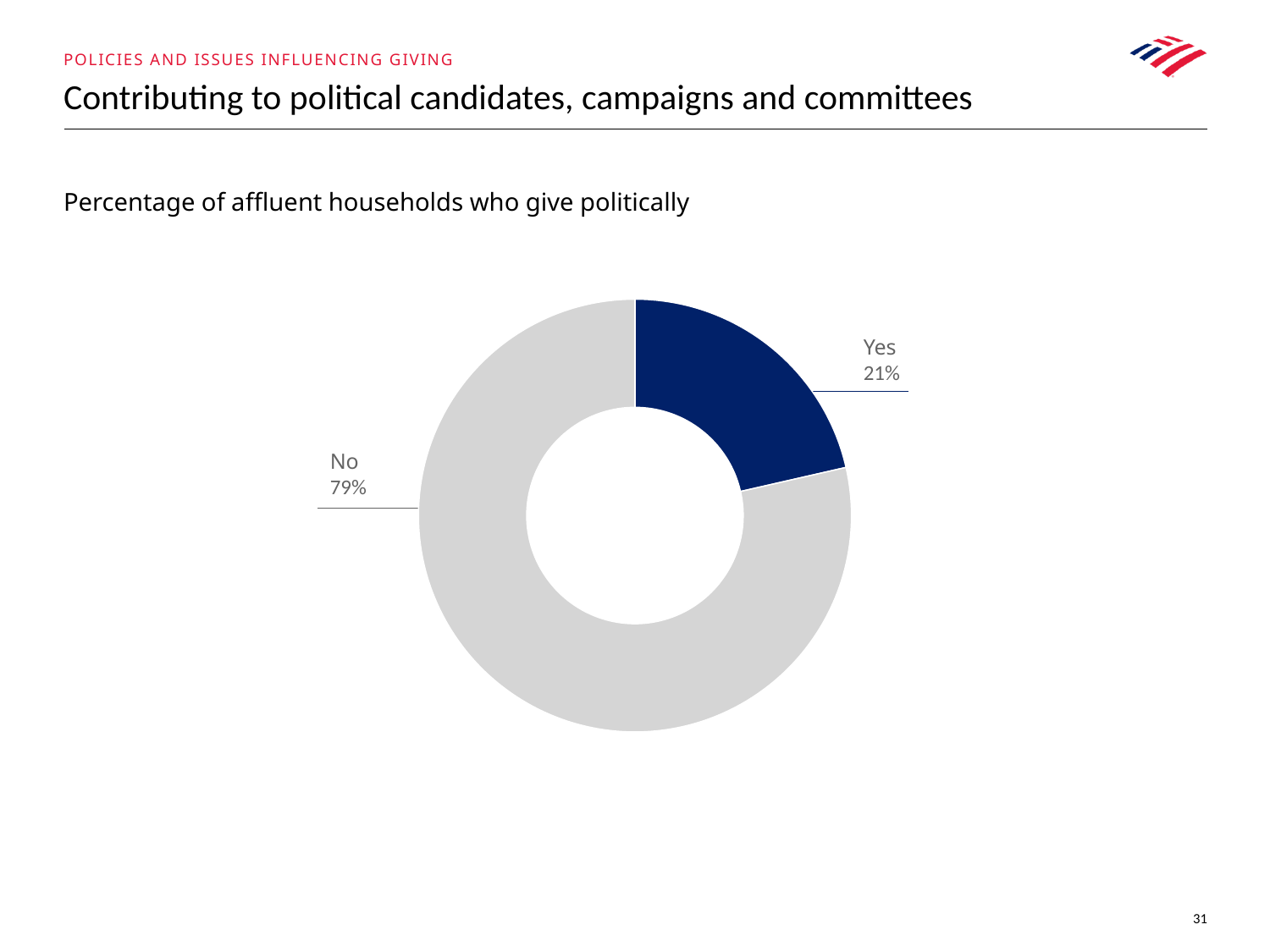
What percentage of affluent households answered "Yes" to giving politically? 21% How many categories are shown in the chart? 2 What percentage of affluent households answered "No" to giving politically? 79% What is the difference in percentage points between the No and Yes shares? 58 Which category has the largest share of the chart? No Which category has the smallest share of the chart? Yes What is the subtitle describing what the chart shows? Percentage of affluent households who give politically What kind of chart is shown on the slide? Doughnut (pie) chart Which colour is used for the Yes slice of the chart? Dark blue Is the share for Yes greater or less than 50%? less What share of the chart does the Yes slice represent? 21% Which category has the larger share of the chart, Yes or No? No